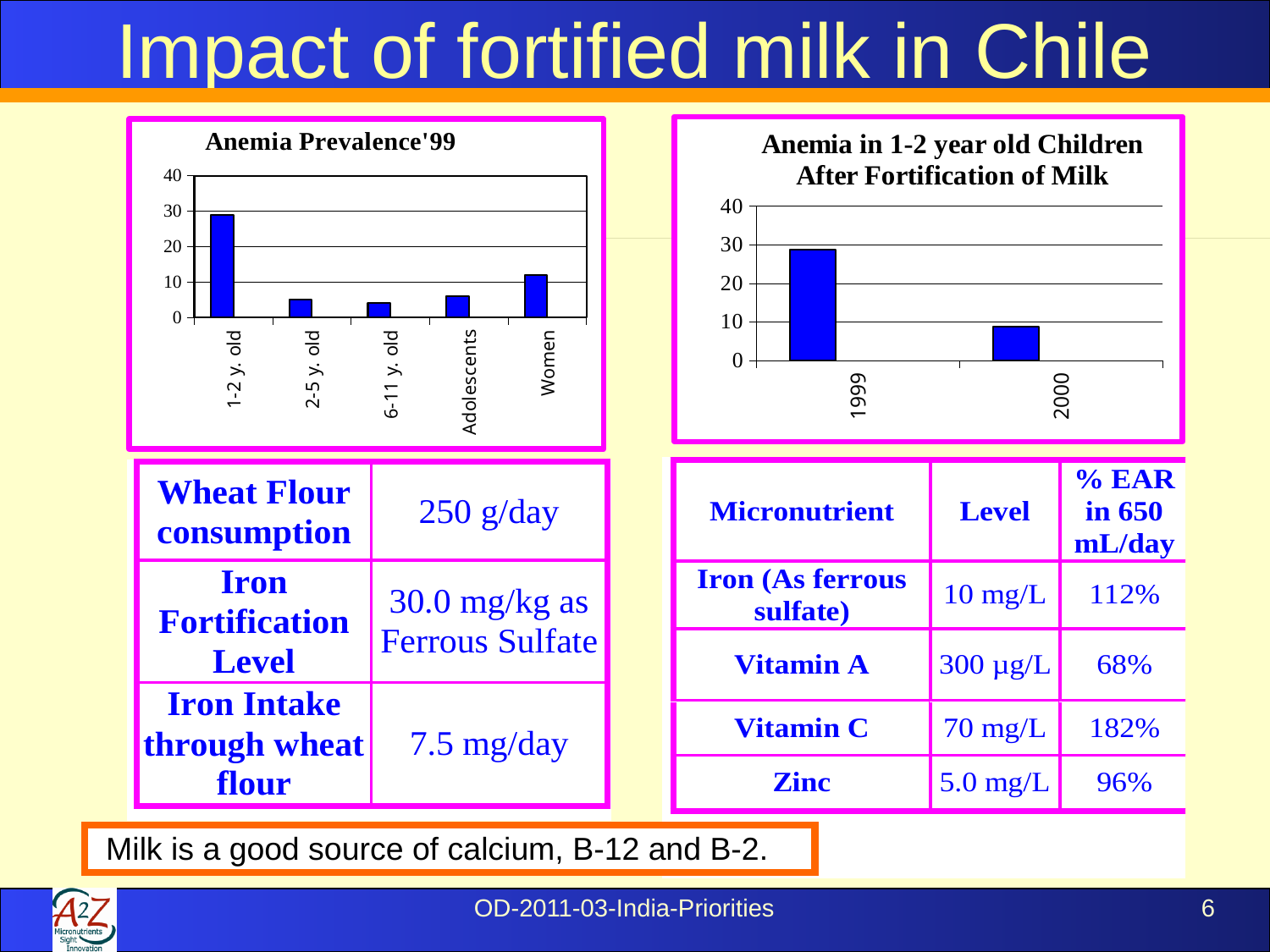
In the 'Anemia Prevalence'99' chart, which category has the highest value? 1-2 y. old What kind of chart is the 'Anemia Prevalence'99' chart? bar chart What kind of chart is the 'Anemia in 1-2 year old Children After Fortification of Milk' chart? bar chart In the 'Anemia Prevalence'99' chart, which is larger, the value for Women or the value for Adolescents? Women In the 'Anemia Prevalence'99' chart, is the value for 1-2 y. old greater or less than 20? greater What is the title of the chart on the right side of the slide? Anemia in 1-2 year old Children After Fortification of Milk How many categories are shown on the x axis of the 'Anemia Prevalence'99' chart? 5 In the 'Anemia in 1-2 year old Children After Fortification of Milk' chart, do the values rise or fall from 1999 to 2000? fall How many bars are shown in the 'Anemia in 1-2 year old Children After Fortification of Milk' chart? 2 In the 'Anemia Prevalence'99' chart, is the value for Women greater or less than 10? greater In the 'Anemia Prevalence'99' chart, is the value for 2-5 y. old greater or less than 10? less